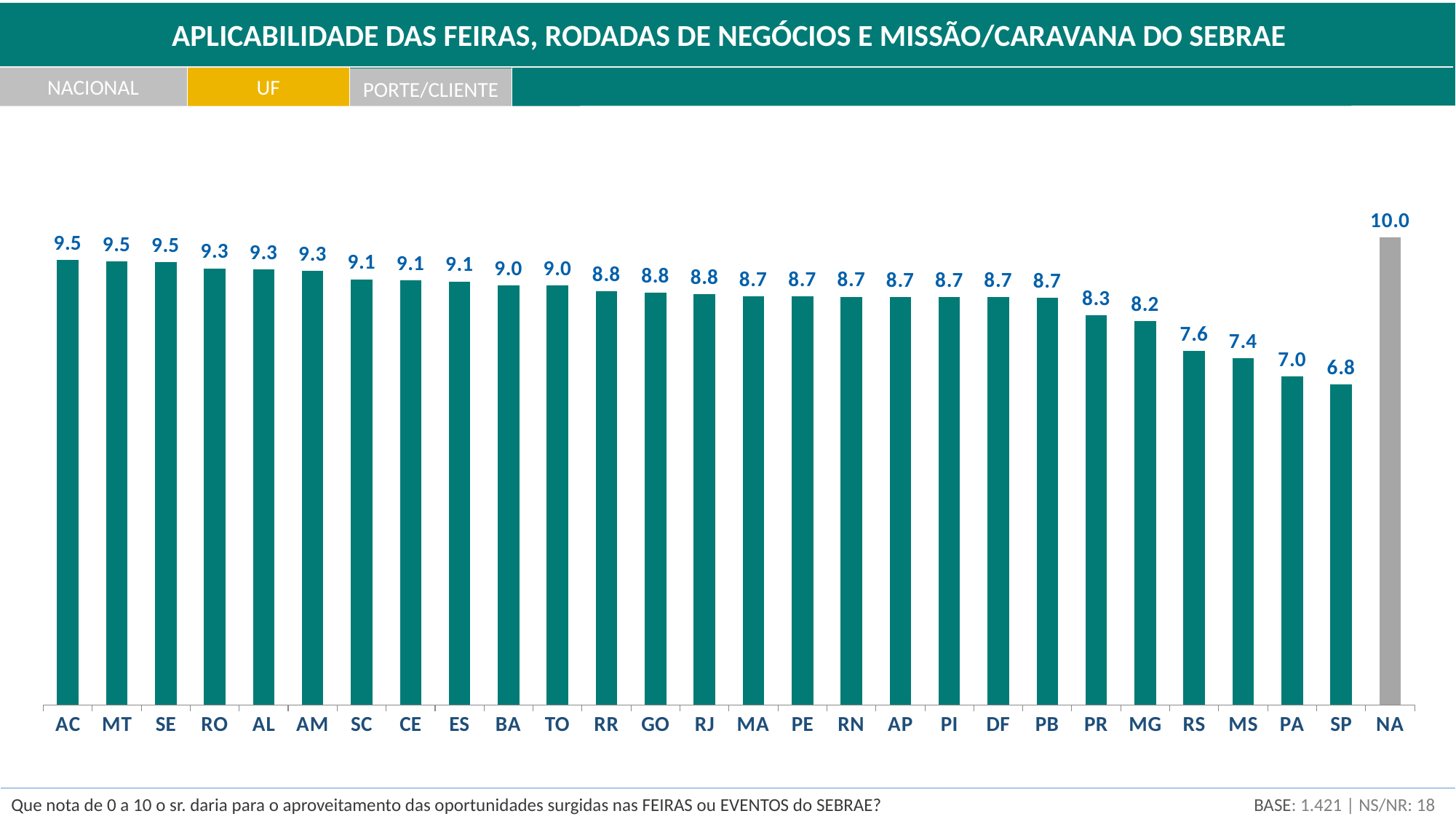
What is the value for SP? 6.8 What is the difference between the values for NA and SP? 3.2 How many categories are shown on the x axis? 28 What kind of chart is this? bar chart What is the value for PR? 8.3 Do the values rise or fall along the x axis from AC to SP? fall What is the value for NA? 10.0 Which category has the highest value? NA Which category has the lowest value? SP What is the difference between the values for AC and PA? 2.5 What is the value for RO? 9.3 Which is larger, the value for MG or the value for RS? MG